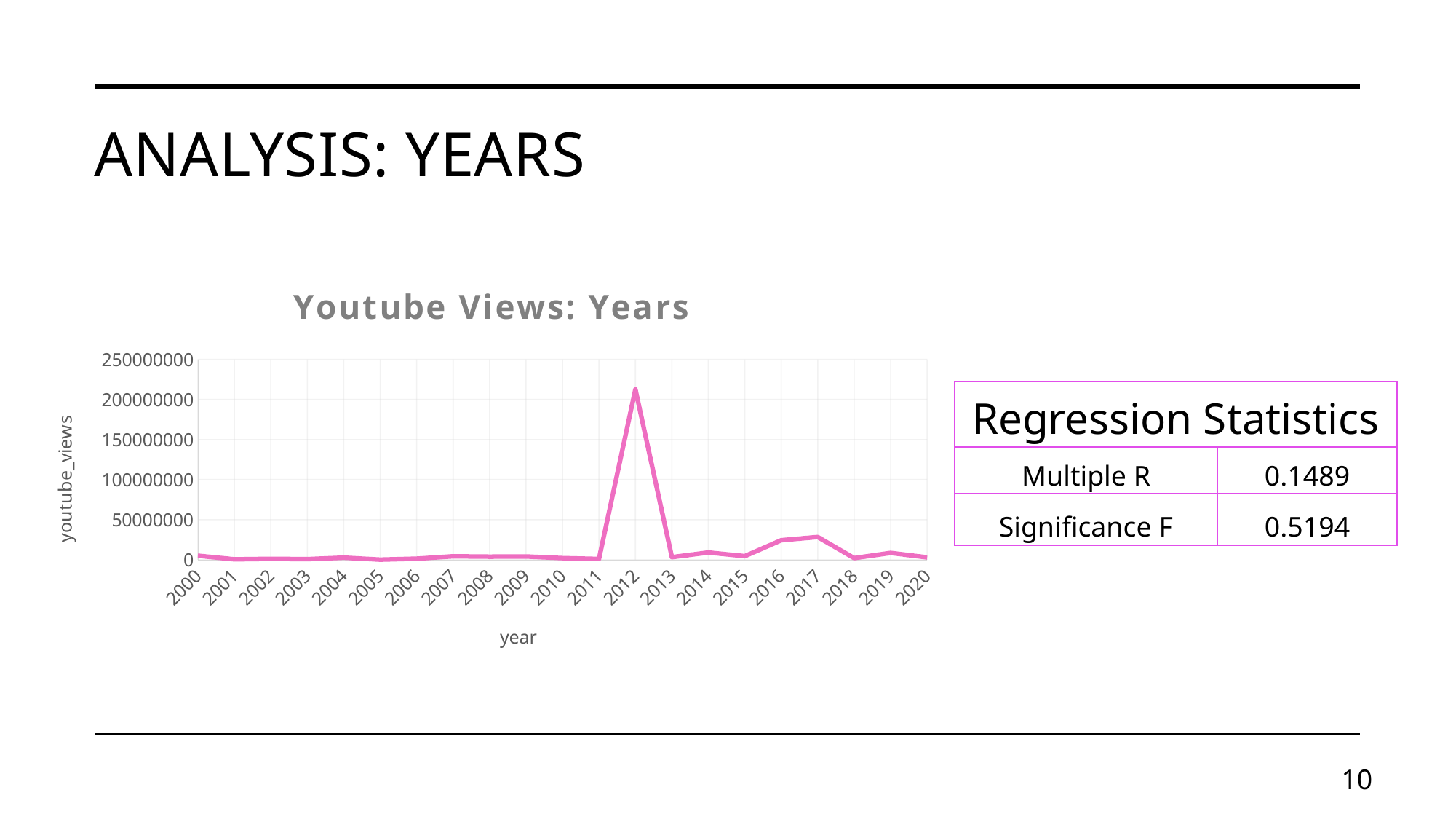
What is the highest tick value shown on the y axis of the chart? 250000000 What is the first year shown on the x axis of the chart? 2000 Which is larger, the value for 2017 or the value for 2018? 2017 What is the label of the y axis of the chart? youtube_views Is the value for 2012 greater or less than 150000000? greater Is the value for 2017 greater or less than 50000000? less What kind of chart is shown on the slide? line chart Which year has the highest youtube_views value in the chart? 2012 What is the title of the chart? Youtube Views: Years How many years are plotted along the x axis of the chart? 21 Is the value for 2013 greater or less than 50000000? less Which is larger, the value for 2012 or the value for 2013? 2012